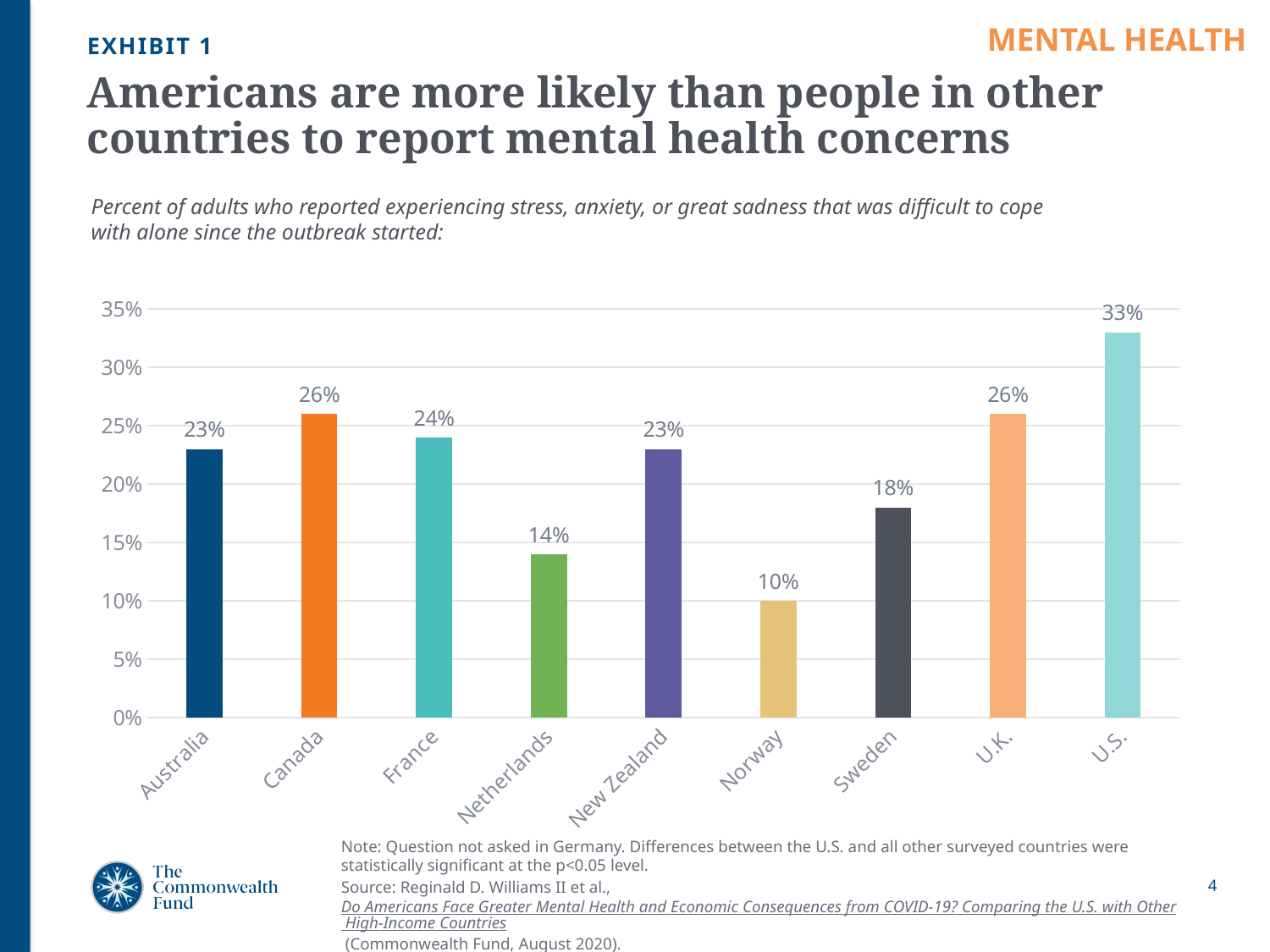
Which country has the lowest value in the chart? Norway Which has a larger value, France or Sweden? France What is the difference between the values for Canada and Norway? 16 percentage points What is the difference between the U.S. value and the U.K. value? 7 percentage points Is the value for New Zealand greater or less than 20%? greater What percent of adults in the U.S. reported experiencing stress, anxiety, or great sadness that was difficult to cope with alone? 33% What is the value shown for the Netherlands? 14% How many countries are shown in the chart? 9 What type of chart is shown on the slide? Bar chart What is the highest value labeled on the vertical axis? 35% What is the value shown for Sweden? 18% Which country has the highest value in the chart? U.S.